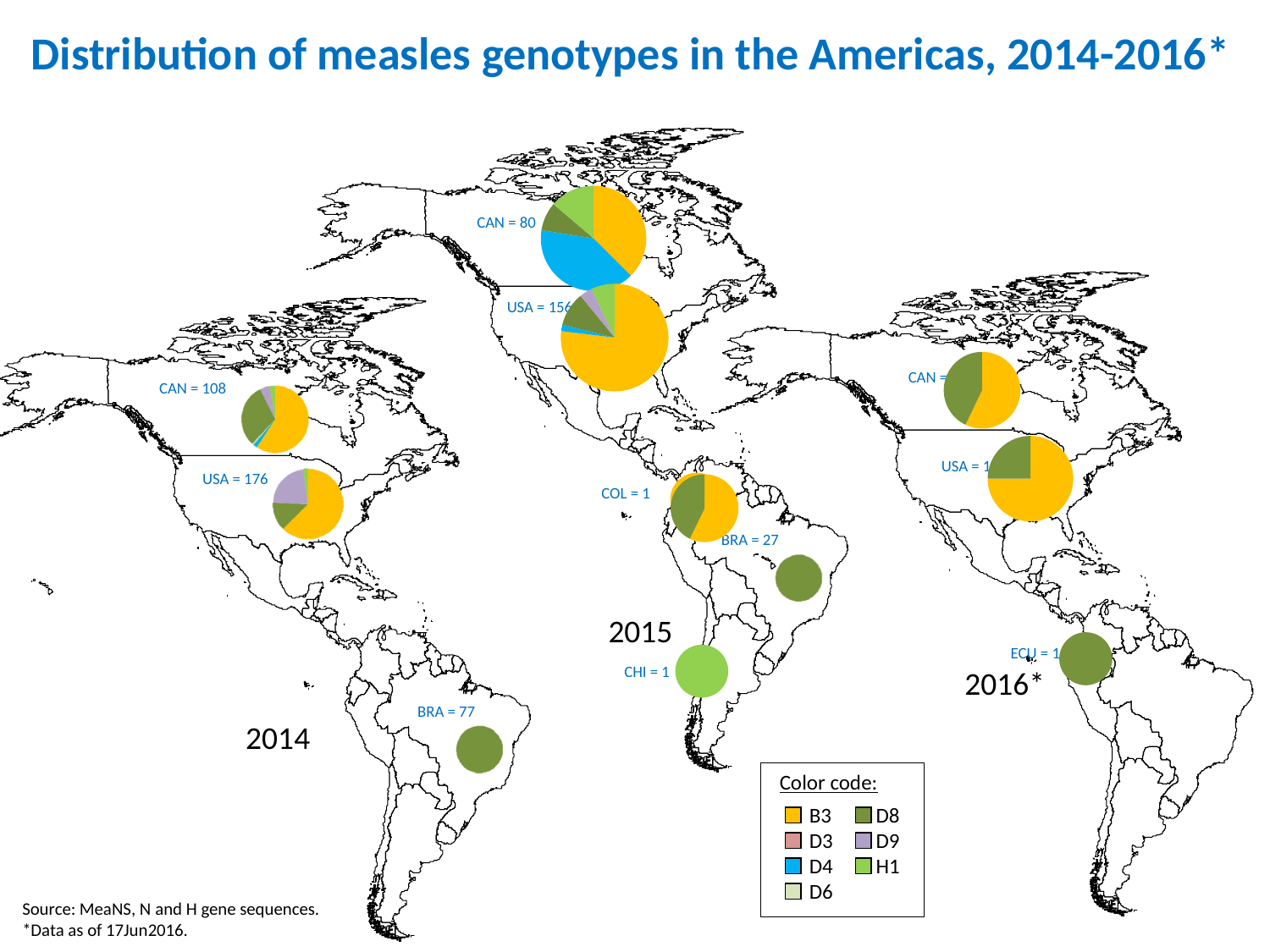
What is the total number of sequences shown for CAN on the 2015 map? 80 What kind of chart is used to show the genotype distribution for each country? Pie chart On the 2015 map, which is larger, the CAN total or the BRA total? CAN How many genotypes are listed in the color code legend? 7 What is the total number of sequences shown for BRA on the 2015 map? 27 What is the total number of sequences shown for BRA on the 2014 map? 77 On the 2014 map, which country has the lowest number of sequences? BRA On the 2014 map, which country has the highest number of sequences? USA What is the total number of sequences shown for CAN on the 2014 map? 108 On the 2014 map, what is the difference between the USA total and the CAN total? 68 What is the total number of sequences shown for USA on the 2014 map? 176 What is the total number of sequences shown for ECU on the 2016 map? 1